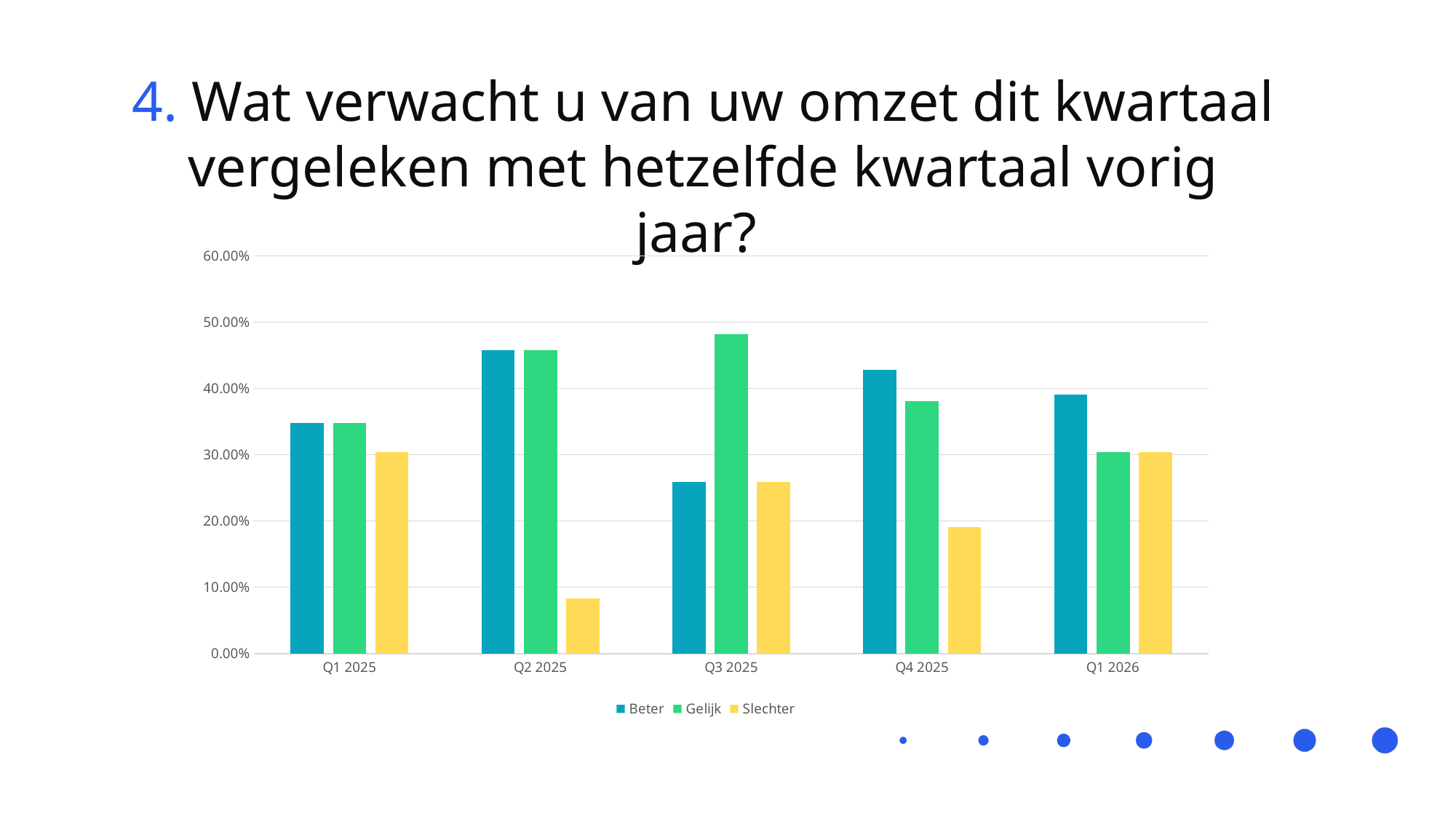
In which quarter is the Slechter value lowest? Q2 2025 What are the three legend entries of the chart? Beter, Gelijk, Slechter How many quarters are shown on the x axis? 5 In Q1 2026, which is larger: Beter or Slechter? Beter Is the value for Beter in Q3 2025 greater or less than 30.00%? less In Q4 2025, which is larger: Beter or Gelijk? Beter In which quarter is the Gelijk value highest? Q3 2025 What kind of chart is shown on the slide? bar chart How many series does the legend list? 3 Is the value for Slechter in Q2 2025 greater or less than 10.00%? less Does the Slechter value rise or fall from Q1 2025 to Q2 2025? fall Is the value for Gelijk in Q3 2025 greater or less than 40.00%? greater